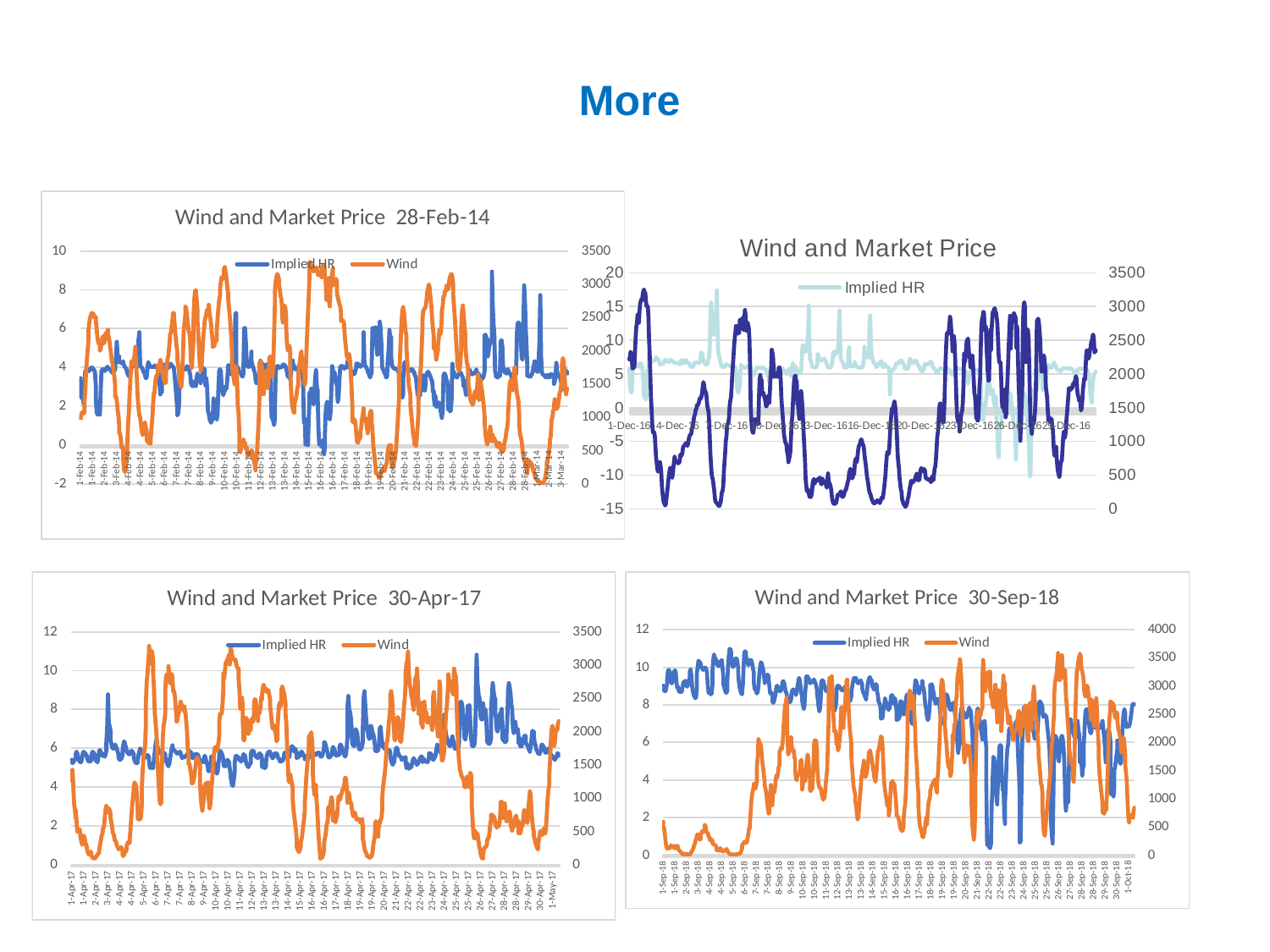
In the top-right 'Wind and Market Price' chart, what is the lowest value shown on the left-hand axis? -15 In the 'Wind and Market Price 30-Apr-17' chart, is the Implied HR value at 1-Apr-17 greater or less than 4 on the left axis? greater In the 'Wind and Market Price 30-Sep-18' chart, what is the highest value shown on the right-hand axis? 4000 In the 'Wind and Market Price 28-Feb-14' chart, what is the lowest value shown on the left-hand axis? -2 In the 'Wind and Market Price 28-Feb-14' chart, is the Implied HR value at 1-Feb-14 greater or less than 6 on the left axis? less What is the title of the bottom-left chart? Wind and Market Price 30-Apr-17 How many series does the legend of the top-right 'Wind and Market Price' chart list? 1 What kind of chart is the 'Wind and Market Price 30-Sep-18' chart? line chart In the 'Wind and Market Price 30-Sep-18' chart, is the Implied HR value at 1-Sep-18 greater or less than 8 on the left axis? greater How many series does the legend of the 'Wind and Market Price 30-Apr-17' chart list? 2 What kind of chart is the 'Wind and Market Price 28-Feb-14' chart? line chart What are the two series named in the legend of the 'Wind and Market Price 30-Sep-18' chart? Implied HR and Wind